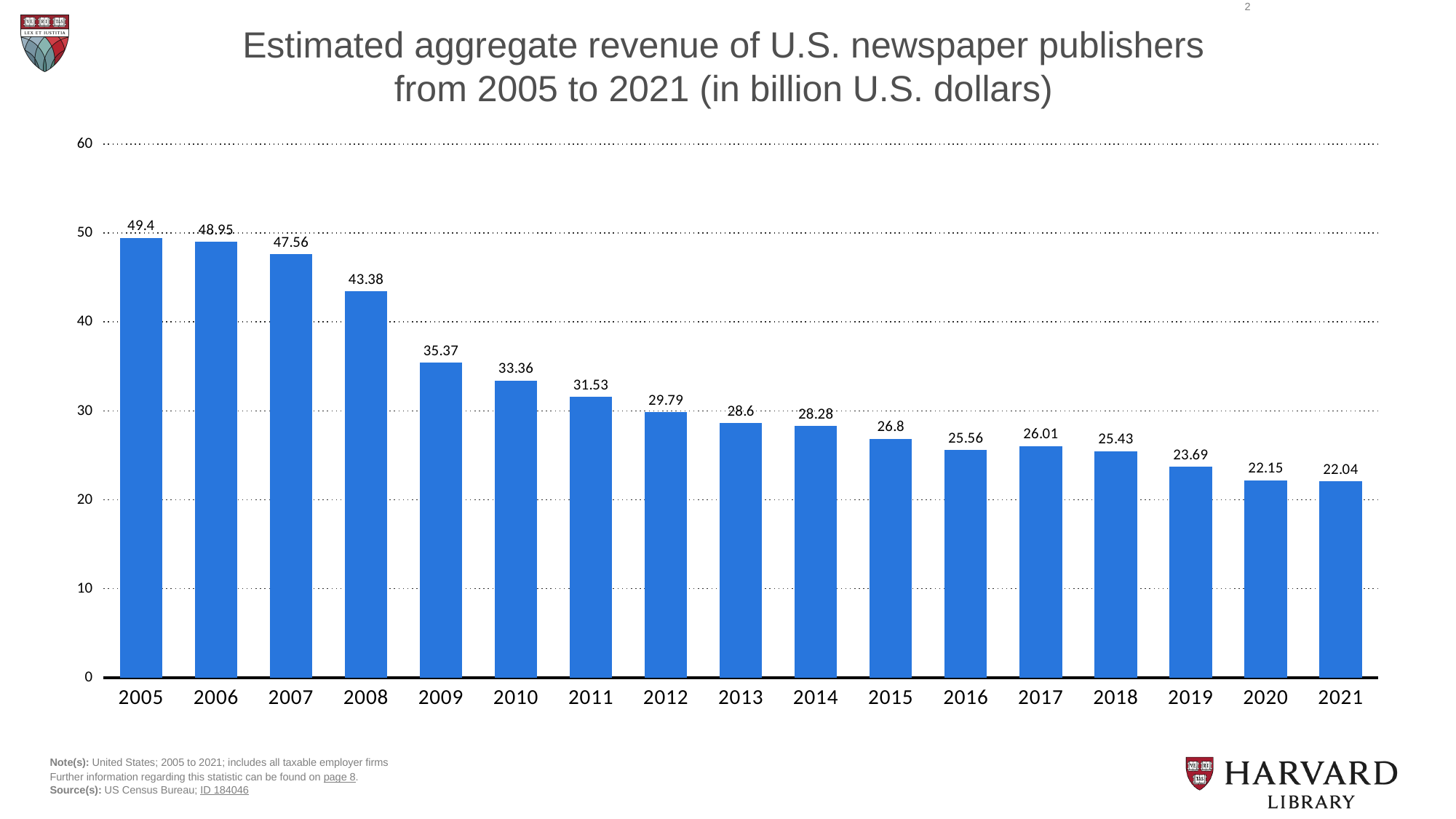
What is the estimated aggregate revenue of U.S. newspaper publishers in 2021? 22.04 Is the value for 2010 greater or less than 30? greater What kind of chart is shown on the slide? Bar chart What is the estimated aggregate revenue of U.S. newspaper publishers in 2013? 28.6 Do the revenue values generally rise or fall from 2005 to 2021? Fall Which year has the lowest estimated aggregate revenue? 2021 What is the difference between the revenue in 2005 and the revenue in 2021? 27.36 How many years are shown on the x axis? 17 Which year has the larger revenue, 2008 or 2009? 2008 What is the source of the data shown in the chart? US Census Bureau Which year has the highest estimated aggregate revenue? 2005 What is the estimated aggregate revenue of U.S. newspaper publishers in 2005? 49.4